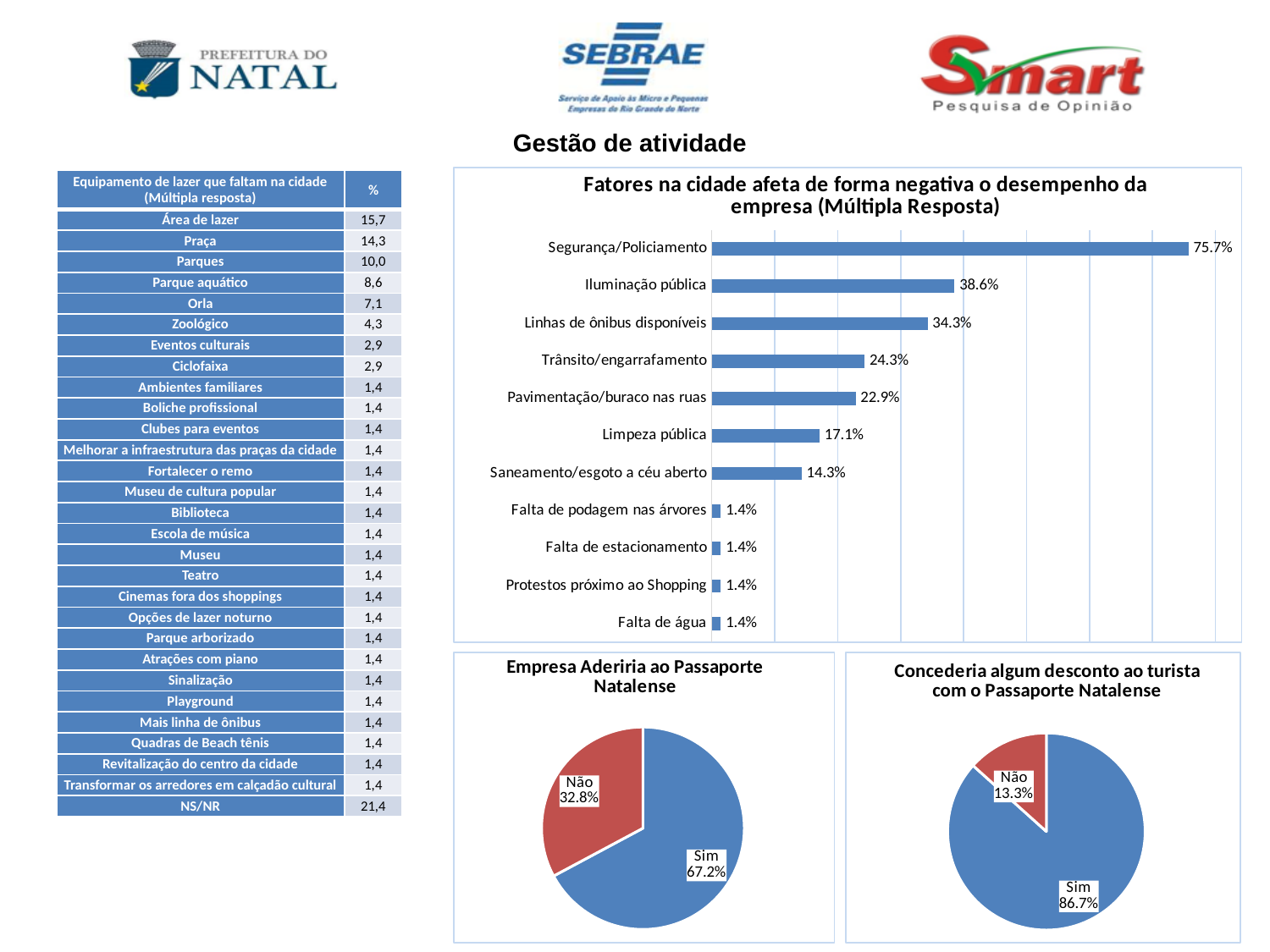
In the chart 'Fatores na cidade afeta de forma negativa o desempenho da empresa', what is the value for Linhas de ônibus disponíveis? 34.3% How many categories are shown in the chart 'Fatores na cidade afeta de forma negativa o desempenho da empresa'? 11 In the pie chart 'Empresa Aderiria ao Passaporte Natalense', what share is Não? 32.8% In the chart 'Fatores na cidade afeta de forma negativa o desempenho da empresa', what is the difference between Iluminação pública and Trânsito/engarrafamento? 14.3% In the pie chart 'Empresa Aderiria ao Passaporte Natalense', what share is Sim? 67.2% What kind of chart is 'Concederia algum desconto ao turista com o Passaporte Natalense'? Pie chart In the pie chart 'Concederia algum desconto ao turista com o Passaporte Natalense', what share is Sim? 86.7% In the chart 'Fatores na cidade afeta de forma negativa o desempenho da empresa', which category has the highest value? Segurança/Policiamento In the chart 'Fatores na cidade afeta de forma negativa o desempenho da empresa', what is the value for Segurança/Policiamento? 75.7% In the chart 'Fatores na cidade afeta de forma negativa o desempenho da empresa', which is larger: Pavimentação/buraco nas ruas or Limpeza pública? Pavimentação/buraco nas ruas What kind of chart is 'Fatores na cidade afeta de forma negativa o desempenho da empresa'? Bar chart In the chart 'Fatores na cidade afeta de forma negativa o desempenho da empresa', what is the value for Saneamento/esgoto a céu aberto? 14.3%